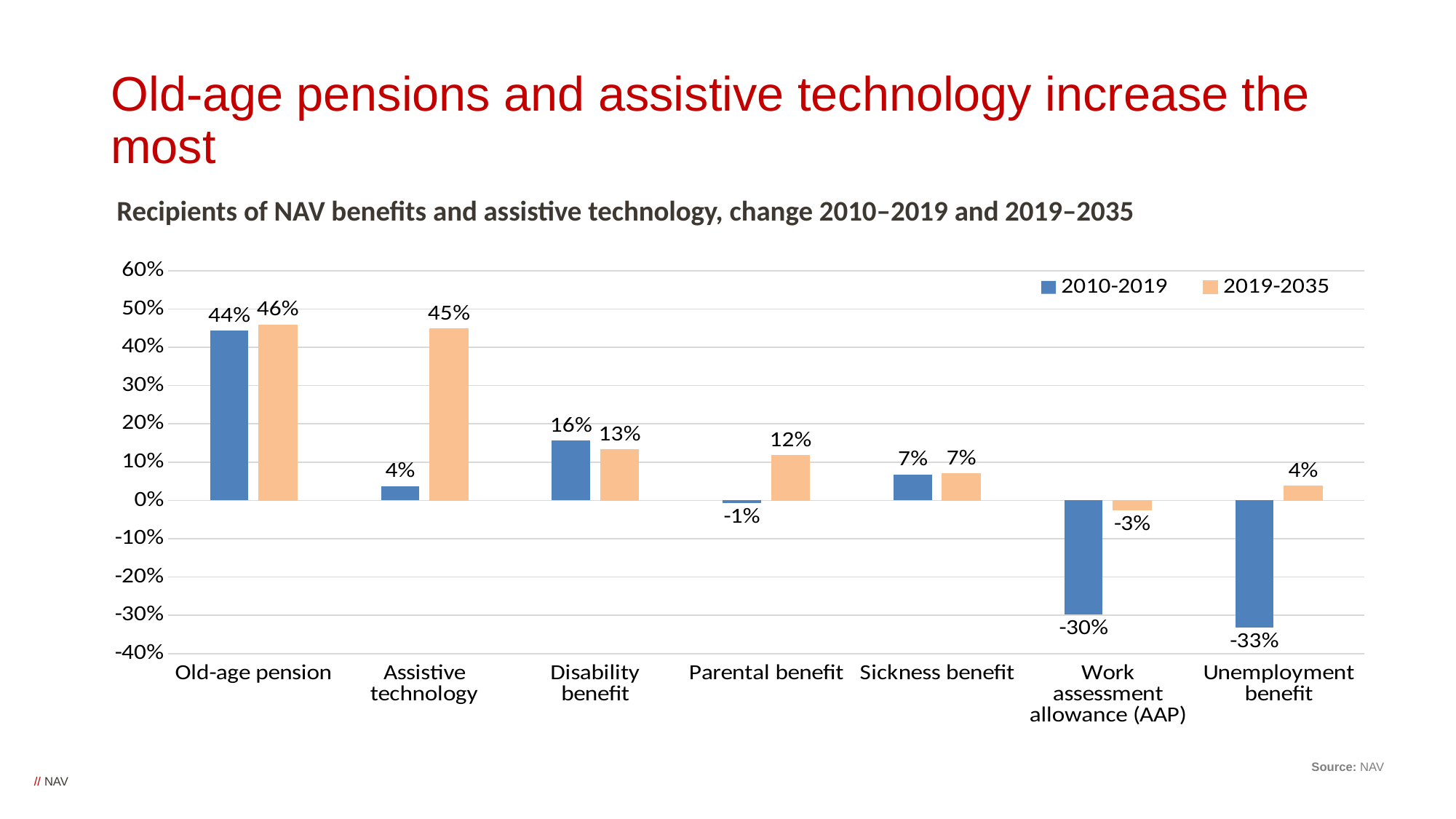
Which is larger for Work assessment allowance (AAP): the 2010-2019 value or the 2019-2035 value? 2019-2035 How many categories are shown on the x axis? 7 How many series does the legend list? 2 Which category has the highest 2019-2035 value? Old-age pension What is the title of the chart? Recipients of NAV benefits and assistive technology, change 2010–2019 and 2019–2035 What kind of chart is shown on the slide? Bar chart What is the 2010-2019 value for Unemployment benefit? -33% What is the 2010-2019 value for Old-age pension? 44% What is the 2019-2035 value for Assistive technology? 45% What is the 2019-2035 value for Parental benefit? 12% What is the difference between the 2010-2019 and 2019-2035 values for Disability benefit? 3% Which category has the lowest 2010-2019 value? Unemployment benefit